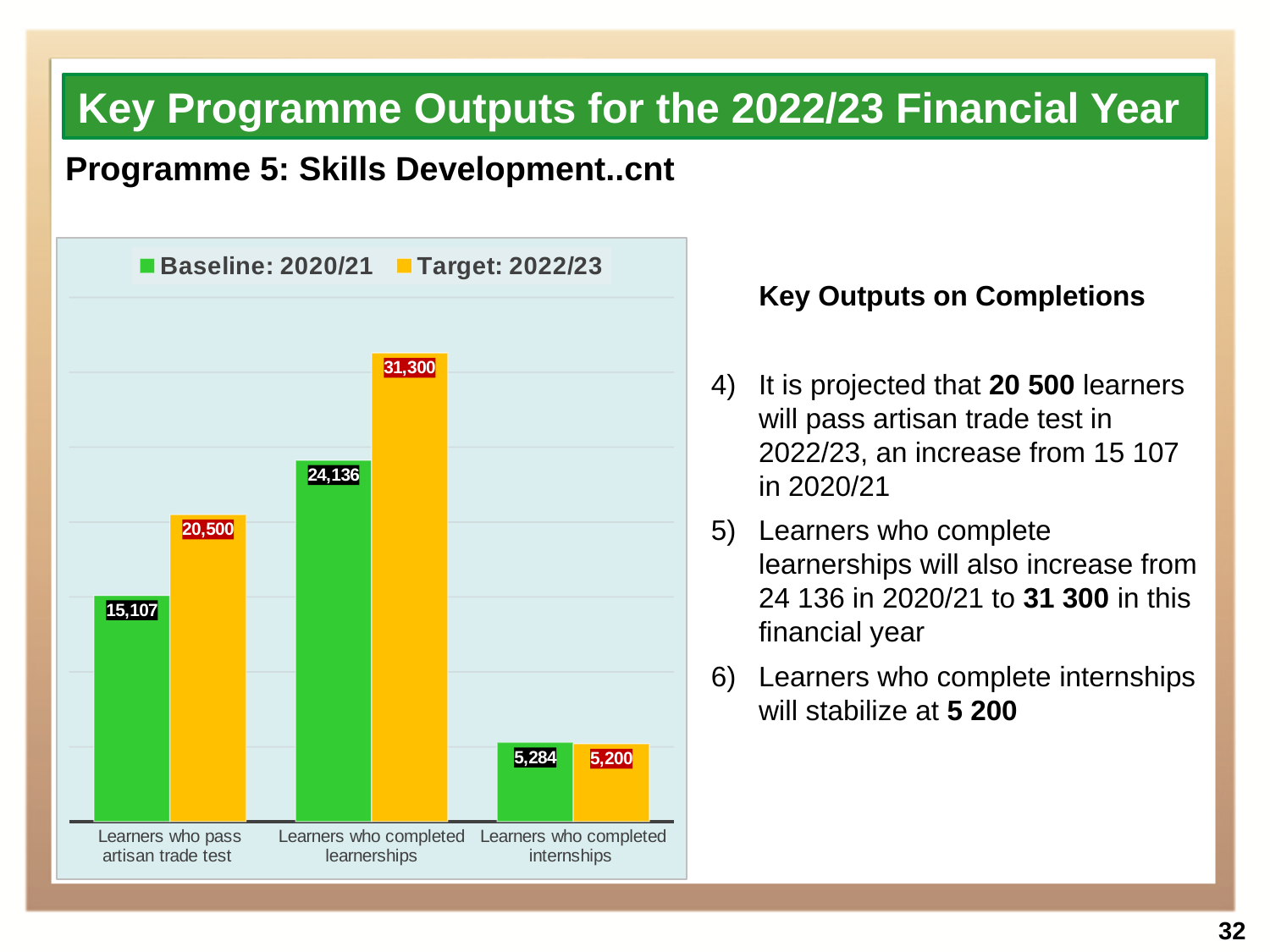
What is the Target: 2022/23 value for Learners who completed learnerships? 31,300 Which category has the lowest Baseline: 2020/21 value? Learners who completed internships What is the Target: 2022/23 value for Learners who completed internships? 5,200 For Learners who completed internships, which is larger: the Baseline: 2020/21 value or the Target: 2022/23 value? Baseline: 2020/21 What is the difference between the Target: 2022/23 and Baseline: 2020/21 values for Learners who completed learnerships? 7,164 What is the difference between the Target: 2022/23 and Baseline: 2020/21 values for Learners who pass artisan trade test? 5,393 What is the Baseline: 2020/21 value for Learners who completed internships? 5,284 How many categories are shown on the x axis of the chart? 3 What is the Baseline: 2020/21 value for Learners who pass artisan trade test? 15,107 How many series does the chart legend list? 2 Which category has the highest Target: 2022/23 value? Learners who completed learnerships What kind of chart is shown on the slide? Bar chart